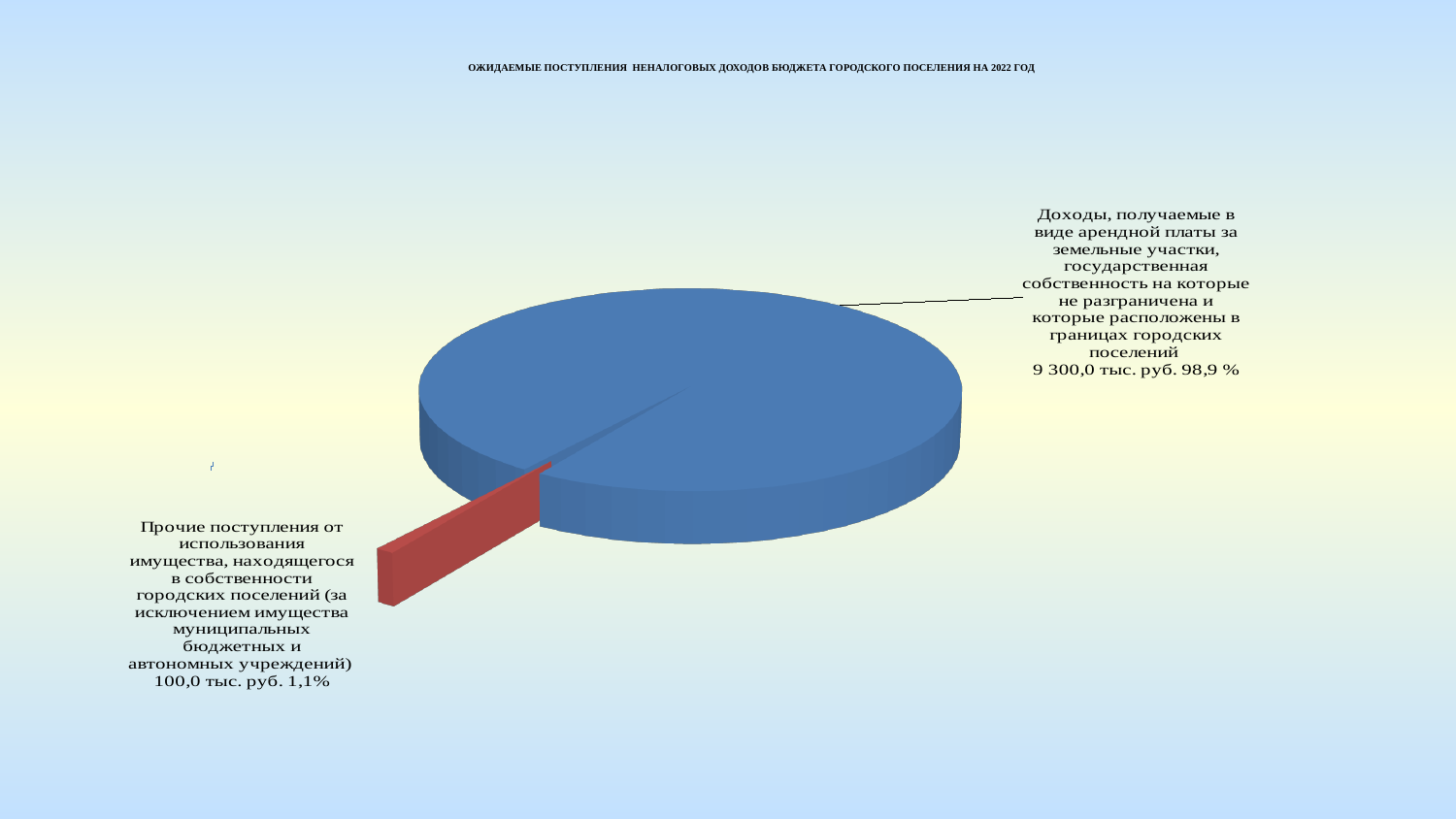
Which is larger: the rental income for land plots slice or the other property income slice? the rental income for land plots slice (Доходы, получаемые в виде арендной платы за земельные участки...) What kind of chart is shown on the slide? pie chart How many slices does the pie chart have? 2 What share of the pie does the slice "Доходы, получаемые в виде арендной платы за земельные участки..." represent? 98,9 % What share of the pie does the slice "Прочие поступления от использования имущества..." represent? 1,1% What is the value shown for the slice "Доходы, получаемые в виде арендной платы за земельные участки..."? 9 300,0 тыс. руб. What is the title of the chart on the slide? ОЖИДАЕМЫЕ ПОСТУПЛЕНИЯ НЕНАЛОГОВЫХ ДОХОДОВ БЮДЖЕТА ГОРОДСКОГО ПОСЕЛЕНИЯ НА 2022 ГОД Which slice of the pie chart is the largest? Доходы, получаемые в виде арендной платы за земельные участки, государственная собственность на которые не разграничена и которые расположены в границах городских поселений Which slice of the pie chart is the smallest? Прочие поступления от использования имущества, находящегося в собственности городских поселений (за исключением имущества муниципальных бюджетных и автономных учреждений) What is the difference in тыс. руб. between the rental income slice (9 300,0) and the other property income slice (100,0)? 9 200,0 тыс. руб. What colour is the slice for "Прочие поступления от использования имущества..."? red What is the value shown for the slice "Прочие поступления от использования имущества, находящегося в собственности городских поселений..."? 100,0 тыс. руб.